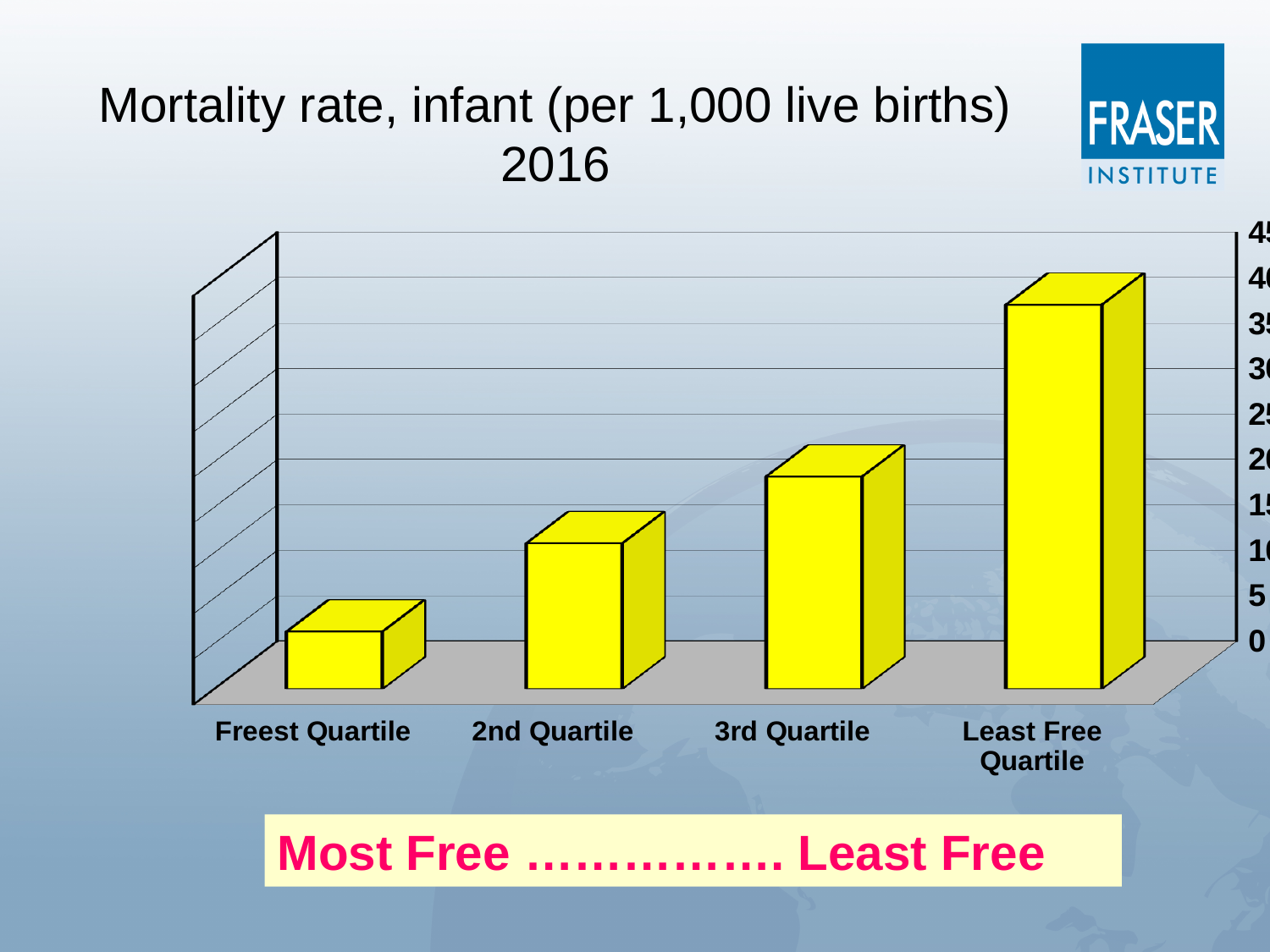
Which quartile has the lowest infant mortality rate? Freest Quartile Which quartile has the highest infant mortality rate? Least Free Quartile Which is larger, the value for the 2nd Quartile or the 3rd Quartile? 3rd Quartile What kind of chart is shown on the slide? bar chart Is the value for the 2nd Quartile greater or less than 10? greater Is the value for the Least Free Quartile greater or less than 45? less Is the value for the Least Free Quartile greater or less than 30? greater Do the values rise or fall moving from the Freest Quartile to the Least Free Quartile? rise What is the title of the chart? Mortality rate, infant (per 1,000 live births) 2016 How many quartile categories are plotted on the chart? 4